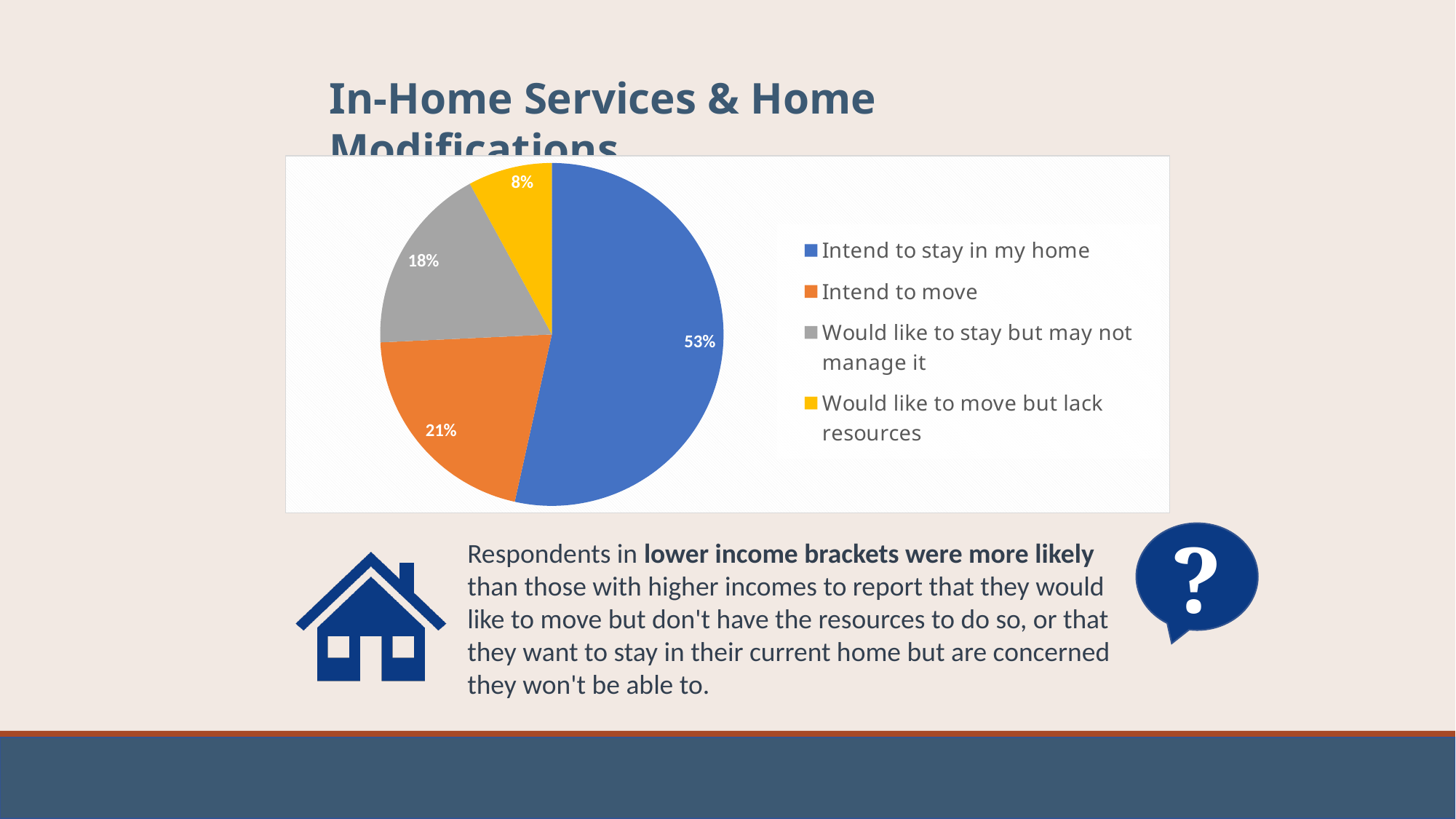
What colour is the slice for 'Would like to move but lack resources'? Yellow What is the difference in percentage points between 'Intend to stay in my home' and 'Intend to move'? 32 What percentage of respondents would like to stay but may not manage it? 18% What is the combined share of 'Would like to stay but may not manage it' and 'Would like to move but lack resources'? 26% Which is larger: the share for 'Intend to move' or the share for 'Would like to stay but may not manage it'? Intend to move What percentage of respondents intend to stay in their home? 53% How many categories does the pie chart show? 4 What percentage of respondents would like to move but lack resources? 8% What percentage of respondents intend to move? 21% What kind of chart is shown on the slide? Pie chart Which category has the largest share of the pie? Intend to stay in my home Which category has the smallest share of the pie? Would like to move but lack resources